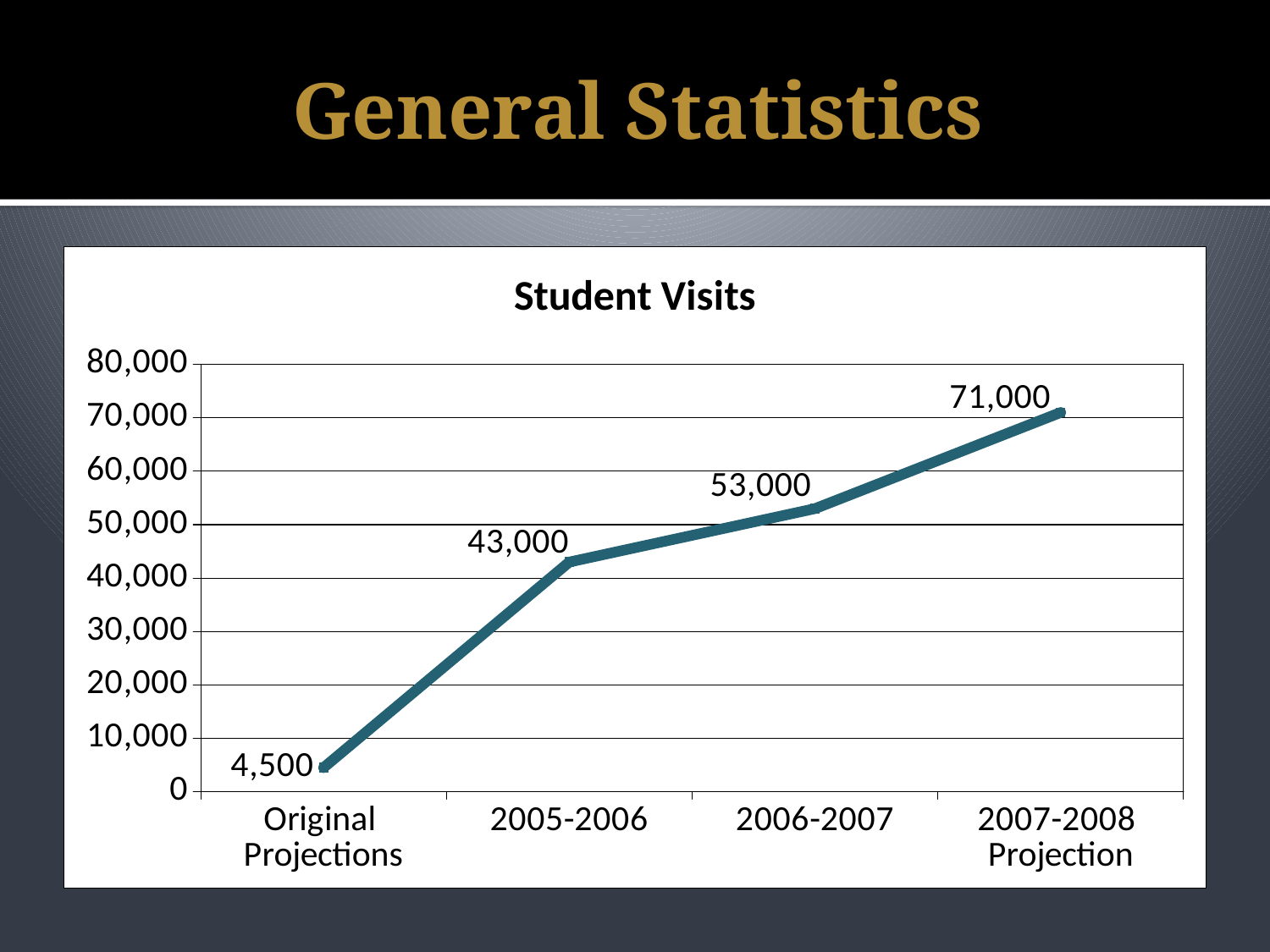
What is the value for 2007-2008 Projection in the Student Visits chart? 71,000 What is the difference between the 2005-2006 value and the Original Projections value? 38,500 What is the value for 2006-2007 in the Student Visits chart? 53,000 What is the difference between the 2007-2008 Projection and the 2006-2007 value? 18,000 Do the values rise or fall from left to right along the x axis? Rise Which category has the highest value in the Student Visits chart? 2007-2008 Projection Which is larger, the value for 2005-2006 or the value for 2006-2007? 2006-2007 How many data points are plotted in the Student Visits chart? 4 What is the value for 2005-2006 in the Student Visits chart? 43,000 Which category has the lowest value in the Student Visits chart? Original Projections What is the value for Original Projections in the Student Visits chart? 4,500 What kind of chart is shown on the slide? Line chart